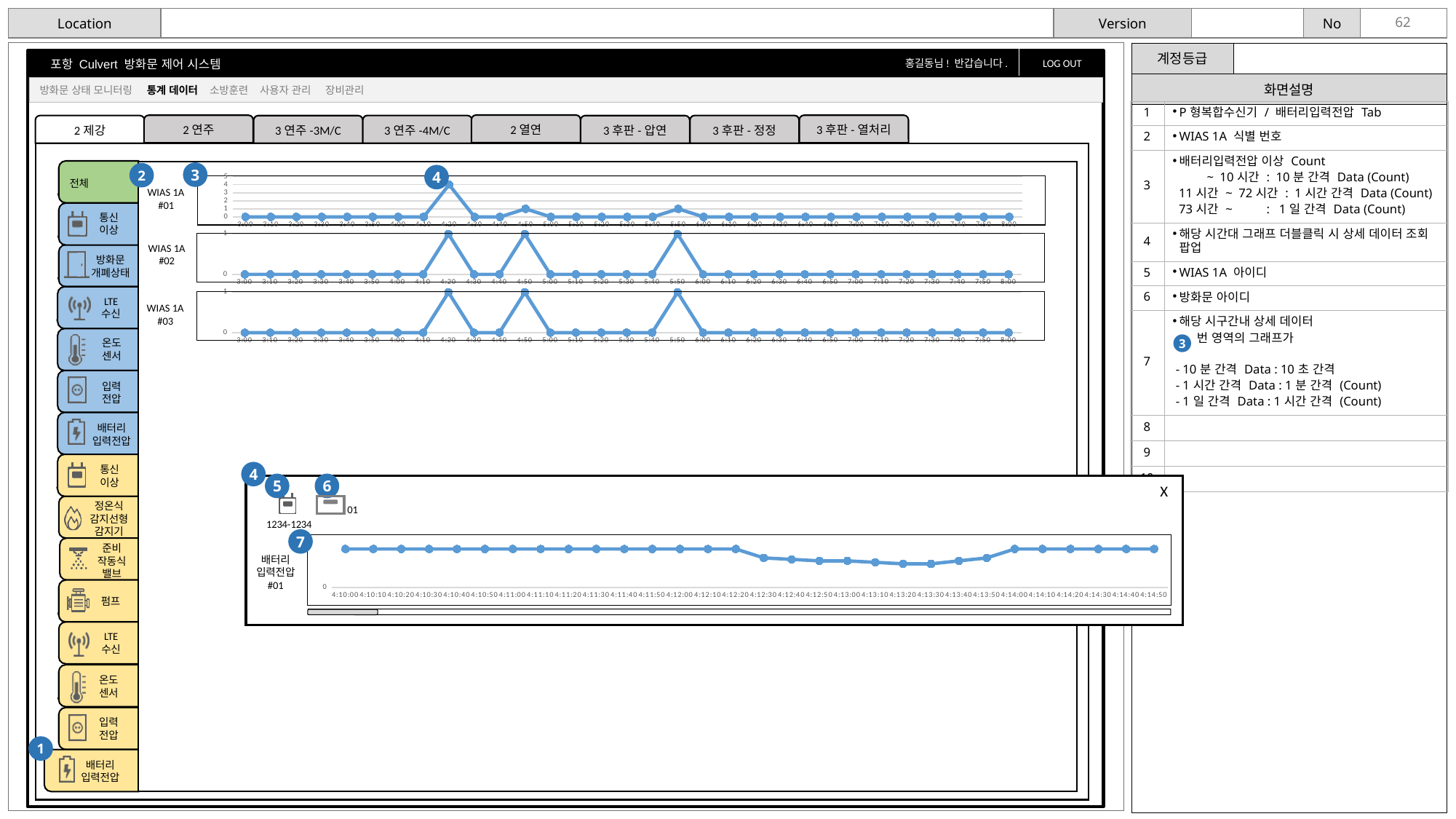
In the WIAS 1A #01 chart, at which time is the value highest? 4:20 In the WIAS 1A #01 chart, what is the value at 3:00? 0 In the 배터리 입력전압 #01 chart in the popup, does the value rise or fall between 4:12:20 and 4:12:40? fall In the WIAS 1A #01 chart, which is larger, the value at 4:20 or the value at 4:50? 4:20 In the WIAS 1A #03 chart, at which times does the value reach 1? 4:20, 4:50, 5:50 What is the highest y-axis tick label on the WIAS 1A #01 chart? 5 In the WIAS 1A #01 chart, is the value at 4:20 greater or less than 3? greater How many line charts are shown on the slide in total? 4 What kind of chart is the WIAS 1A #01 chart? line chart In the WIAS 1A #02 chart, what is the value at 4:20? 1 In the WIAS 1A #02 chart, what is the value at 6:00? 0 What is the first and last x-axis label on the WIAS 1A #03 chart? 3:00 and 8:00